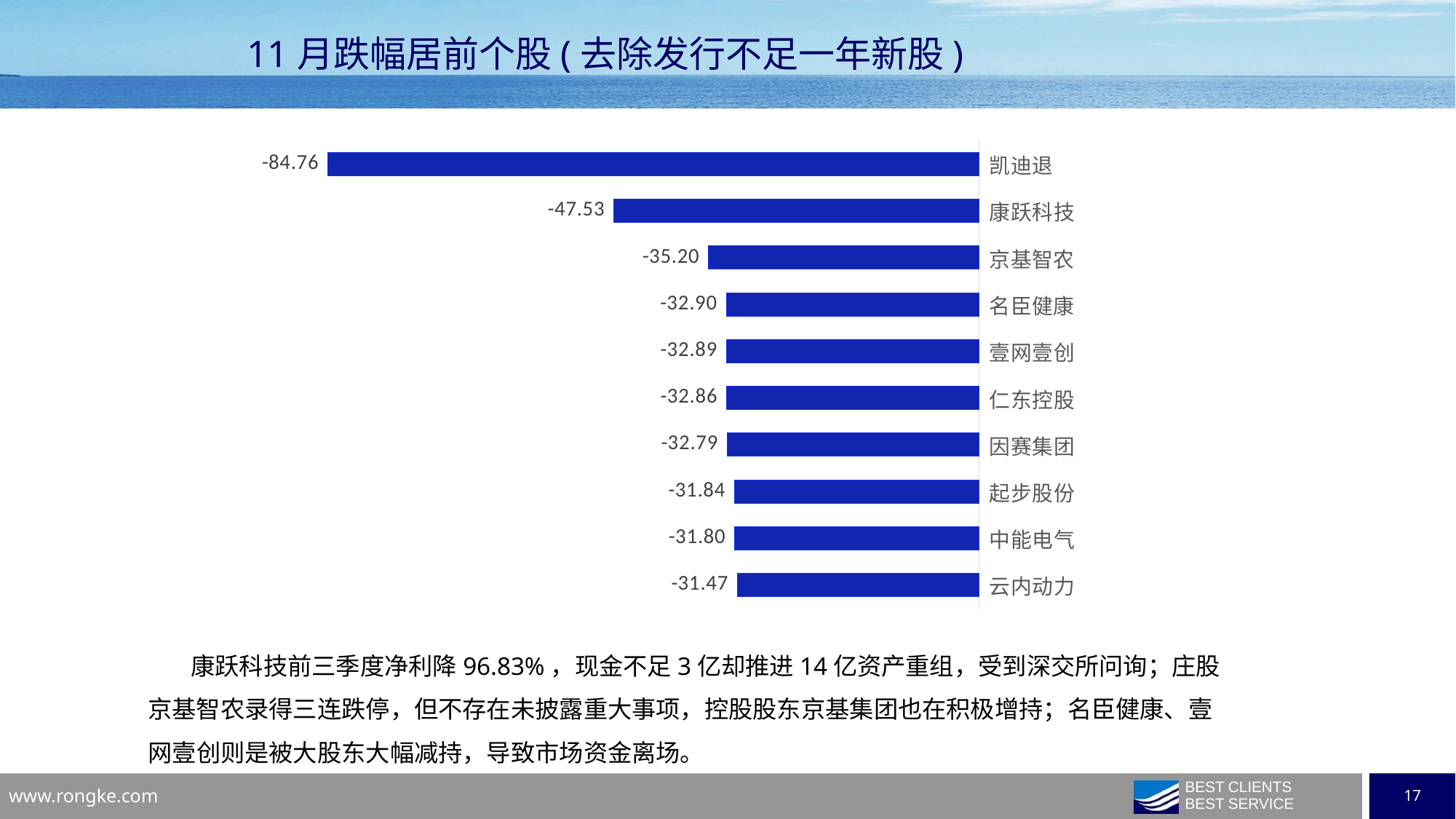
What is the value shown for 起步股份? -31.84 What is the difference between the values for 凯迪退 and 康跃科技? 37.23 Which stock fell more in the chart, 凯迪退 or 康跃科技? 凯迪退 What is the difference between the values for 京基智农 and 名臣健康? 2.30 Which stock has the smallest decline (the highest value) in the chart? 云内动力 Which stock has the largest decline (the lowest value) in the chart? 凯迪退 What is the value shown for 云内动力? -31.47 How many stocks are shown in the chart? 10 What is the value shown for 凯迪退? -84.76 What type of chart is shown on the slide? Bar chart What is the value shown for 康跃科技? -47.53 What is the value shown for 京基智农? -35.20